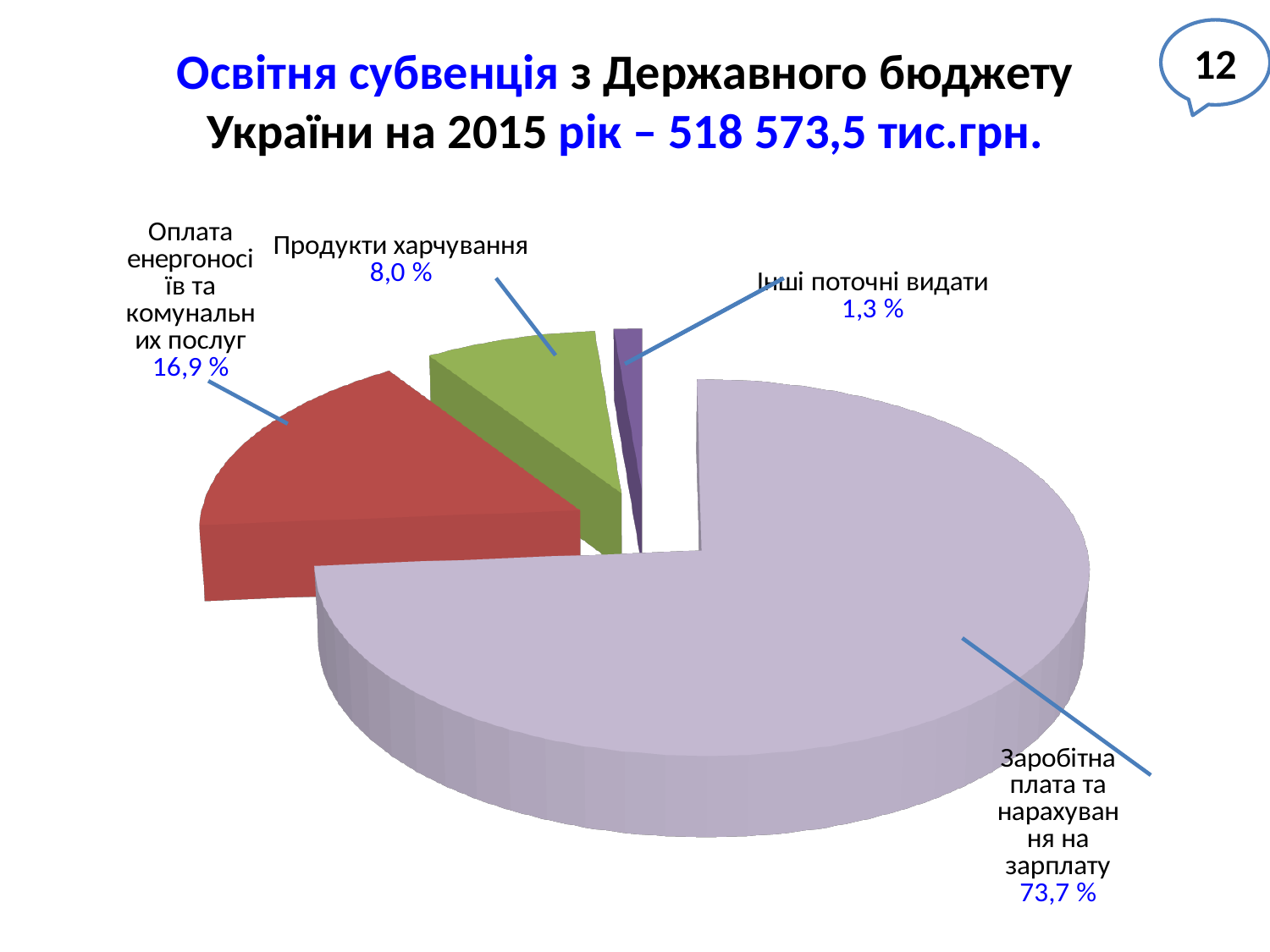
What is the difference in percentage points between the share for "Оплата енергоносіїв та комунальних послуг" and the share for "Продукти харчування"? 8,9 % Which category has the largest slice of the pie? Заробітна плата та нарахування на зарплату Which is larger: the share for "Оплата енергоносіїв та комунальних послуг" or the share for "Продукти харчування"? Оплата енергоносіїв та комунальних послуг What kind of chart is shown on the slide? pie chart What total amount of the educational subvention for 2015 is stated in the slide title? 518 573,5 тис.грн. What share of the pie is labelled for "Оплата енергоносіїв та комунальних послуг"? 16,9 % What share of the pie is labelled for "Інші поточні видати"? 1,3 % What is the difference in percentage points between the share for "Заробітна плата та нарахування на зарплату" and the share for "Інші поточні видати"? 72,4 % How many slices does the pie chart have? 4 What share of the pie is labelled for "Продукти харчування"? 8,0 % Which category has the smallest slice of the pie? Інші поточні видати